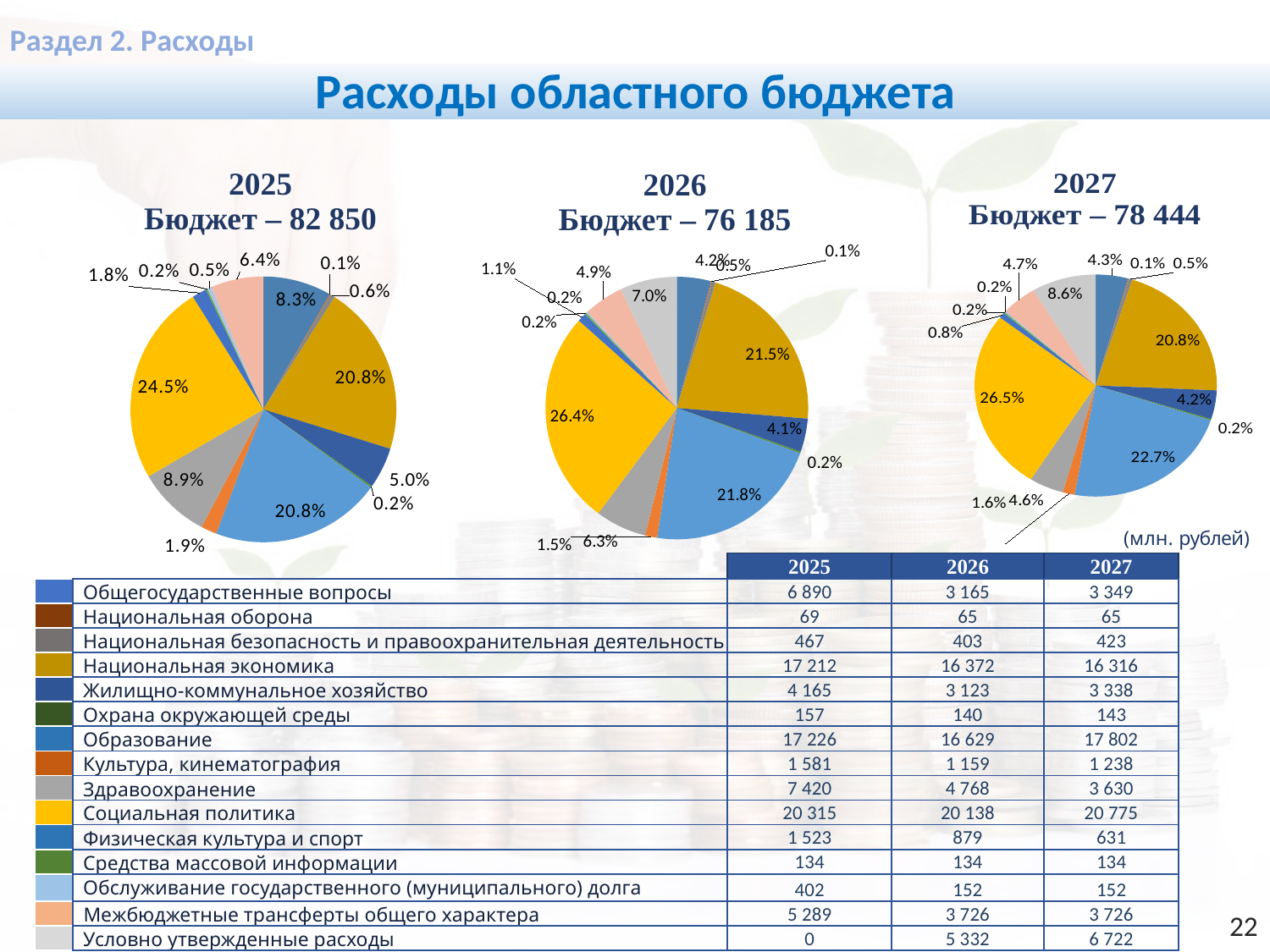
In the table, what is the difference between Условно утвержденные расходы in 2027 and in 2026? 1 390 How many pie charts are on the slide? 3 In the table, what is the value for Социальная политика in 2025? 20 315 In the table, which is larger: Национальная экономика in 2025 or Образование in 2025? Образование In the 2025 pie chart, what is the largest slice's share? 24.5% What total budget is stated above the 2027 pie chart? 78 444 In the 2026 pie chart, what is the largest slice's share? 26.4% In the table, what is the value for Образование in 2027? 17 802 What kind of charts are shown on the slide? Pie charts What total budget is stated above the 2026 pie chart? 76 185 In the 2027 pie chart, what is the largest slice's share? 26.5% In the table, what is the value for Здравоохранение in 2026? 4 768